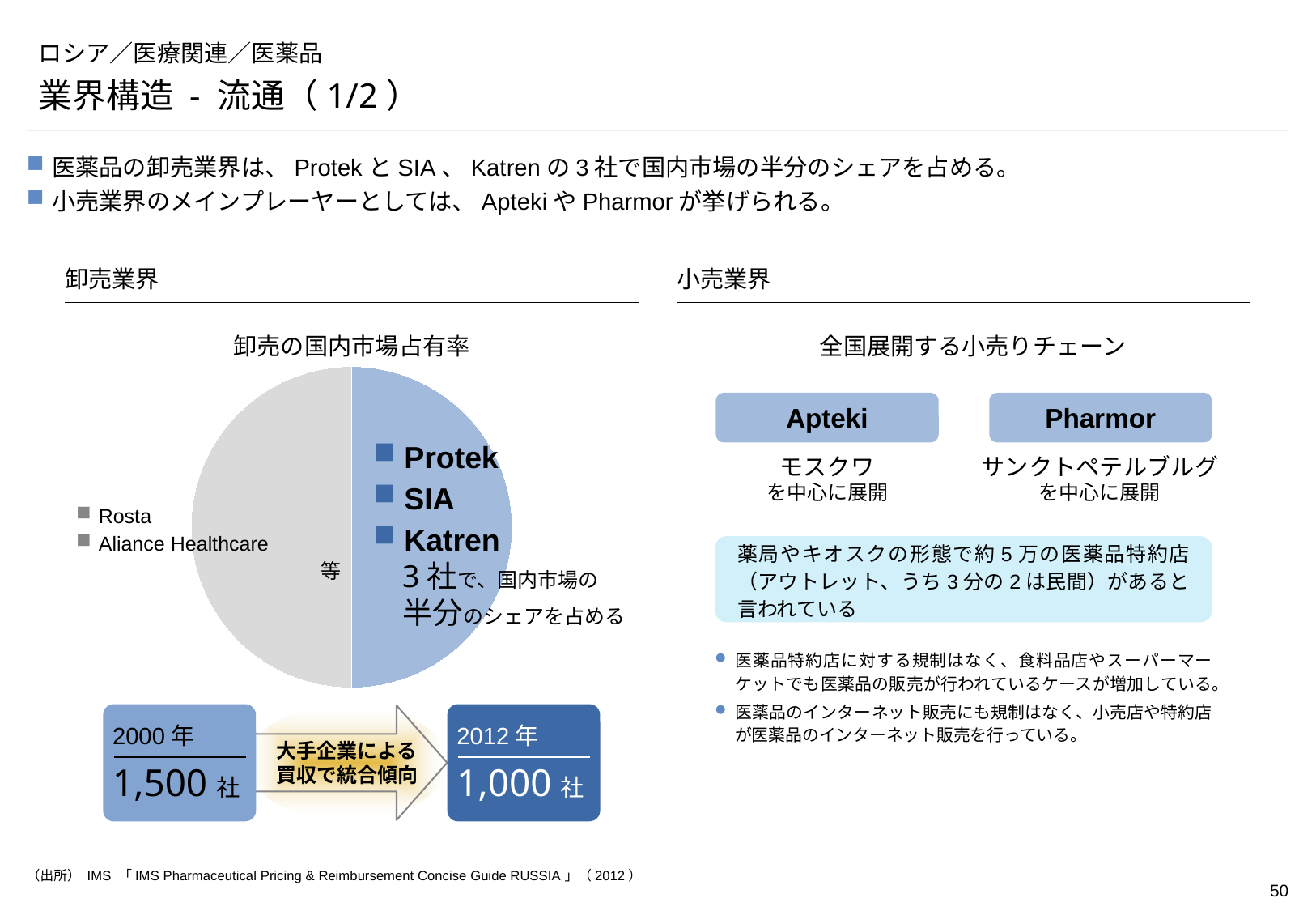
In the pie chart 「卸売の国内市場占有率」, which companies are named in the blue slice? Protek, SIA, Katren In the pie chart 「卸売の国内市場占有率」, what share of the domestic market do Protek, SIA and Katren together hold? 半分 How many slices does the pie chart 「卸売の国内市場占有率」 have? 2 What is the title of the pie chart on the left side of the slide? 卸売の国内市場占有率 What kind of chart is shown under the title 「卸売の国内市場占有率」? pie chart In the pie chart 「卸売の国内市場占有率」, how many companies are named in the blue slice? 3 In the pie chart 「卸売の国内市場占有率」, which companies are named next to the grey slice? Rosta, Aliance Healthcare